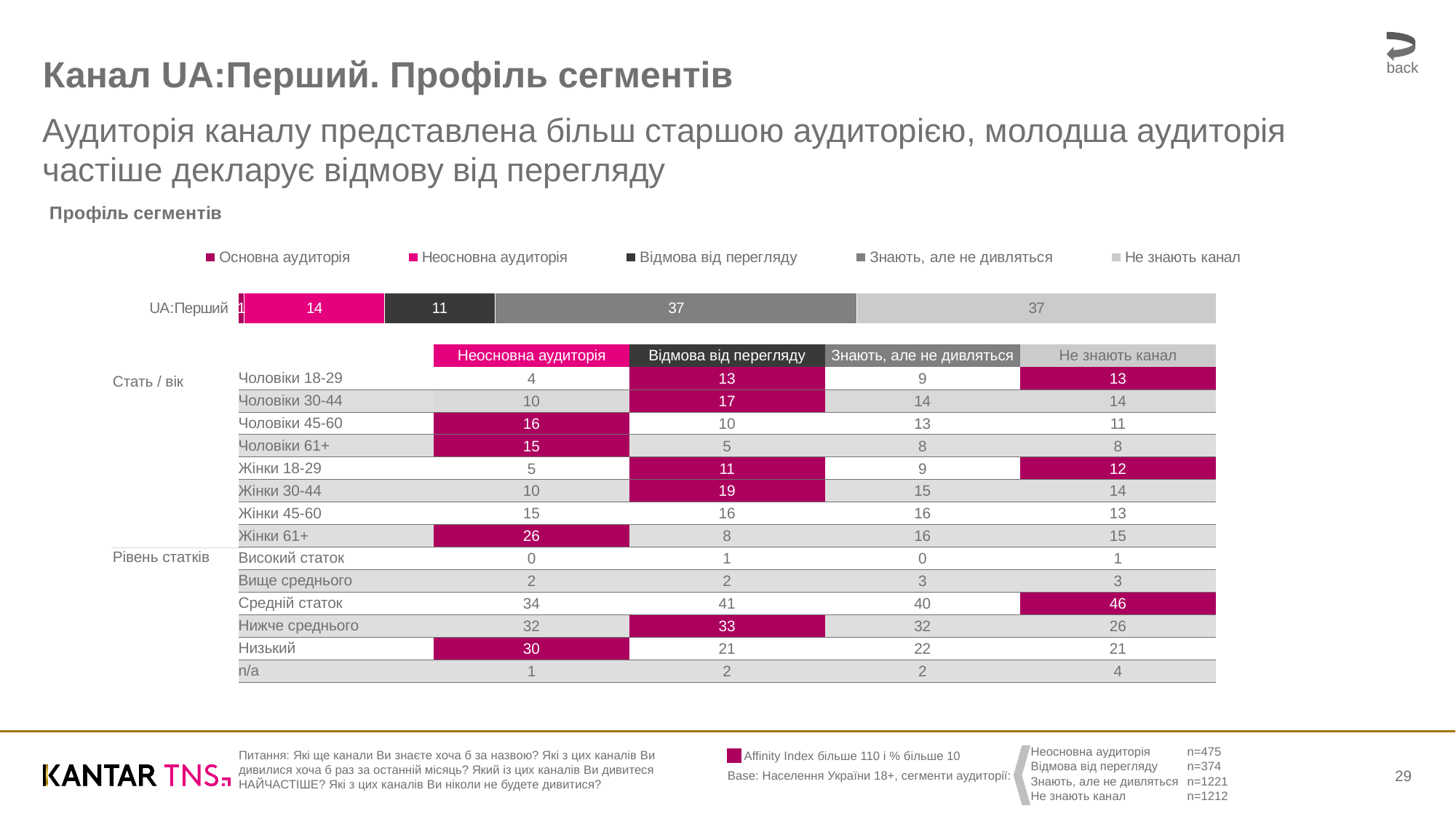
Which legend entry is shown in the lightest grey colour in the stacked bar chart? Не знають канал Which segment of the UA:Перший bar has the smallest value? Основна аудиторія Which is larger in the UA:Перший bar: "Неосновна аудиторія" or "Відмова від перегляду"? Неосновна аудиторія What kind of chart is shown under the heading "Профіль сегментів"? stacked bar chart How many series does the legend of the stacked bar chart list? 5 What is the value of the "Знають, але не дивляться" segment in the UA:Перший bar? 37 How many bars (categories) does the stacked bar chart contain? 1 What is the value of the "Відмова від перегляду" segment in the UA:Перший bar? 11 What is the value of the "Основна аудиторія" segment in the UA:Перший bar? 1 What is the total of all segments in the UA:Перший stacked bar? 100 What is the difference between the "Неосновна аудиторія" and "Відмова від перегляду" segments in the UA:Перший bar? 3 What is the value of the "Неосновна аудиторія" segment in the UA:Перший bar? 14